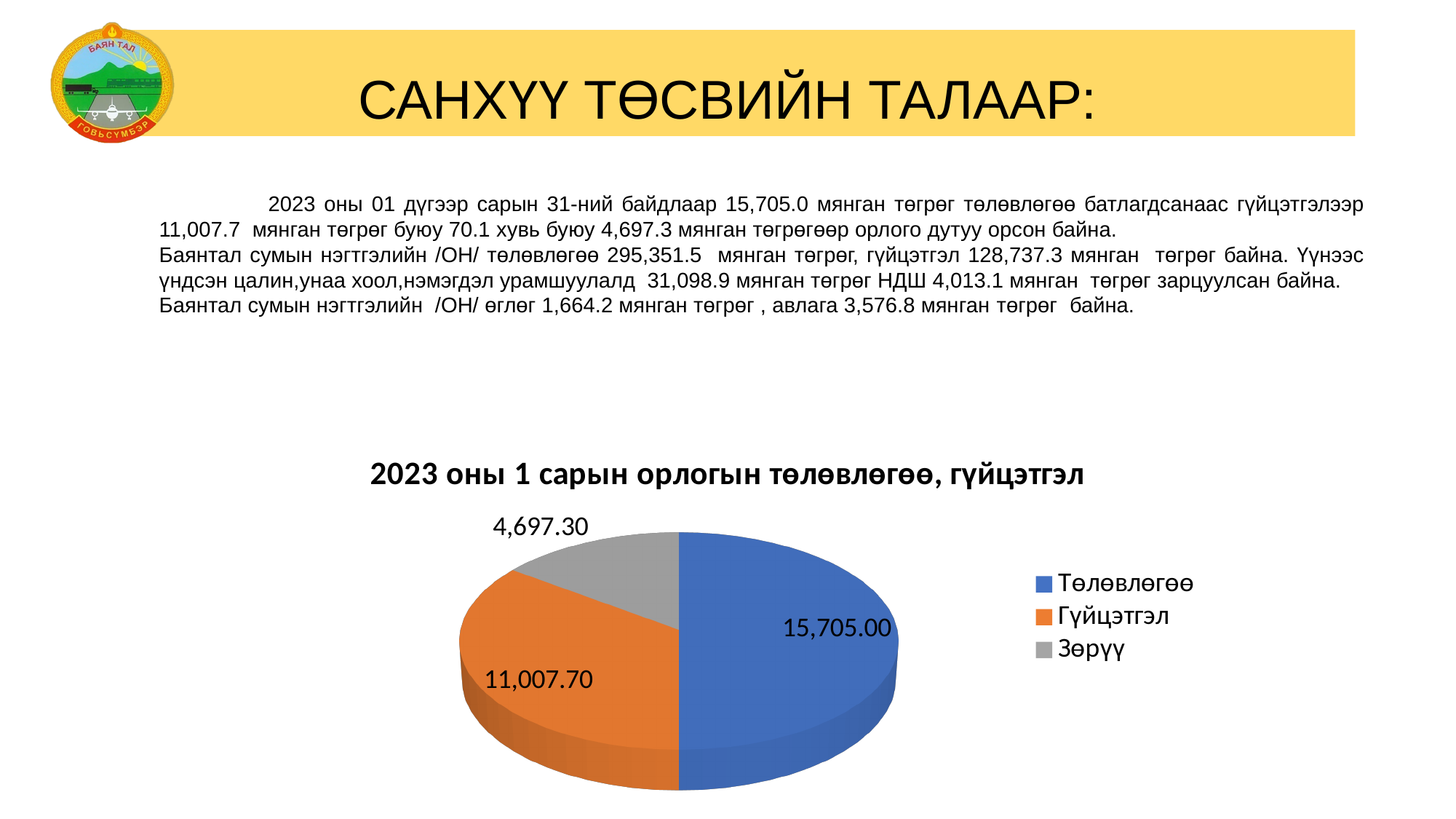
Which category has the largest slice in the pie chart? Төлөвлөгөө What is the value of the Төлөвлөгөө slice in the pie chart? 15,705.00 What is the value of the Зөрүү slice in the pie chart? 4,697.30 What is the value of the Гүйцэтгэл slice in the pie chart? 11,007.70 What is the difference between the Төлөвлөгөө and Гүйцэтгэл values in the pie chart? 4,697.30 What is the difference between the Гүйцэтгэл and Зөрүү values in the pie chart? 6,310.40 Which category has the smallest slice in the pie chart? Зөрүү What is the title of the pie chart? 2023 оны 1 сарын орлогын төлөвлөгөө, гүйцэтгэл Which is larger in the pie chart, Гүйцэтгэл or Зөрүү? Гүйцэтгэл What type of chart is shown on the slide? pie chart How many slices does the pie chart have? 3 What share of the pie does the Төлөвлөгөө slice represent? 50%